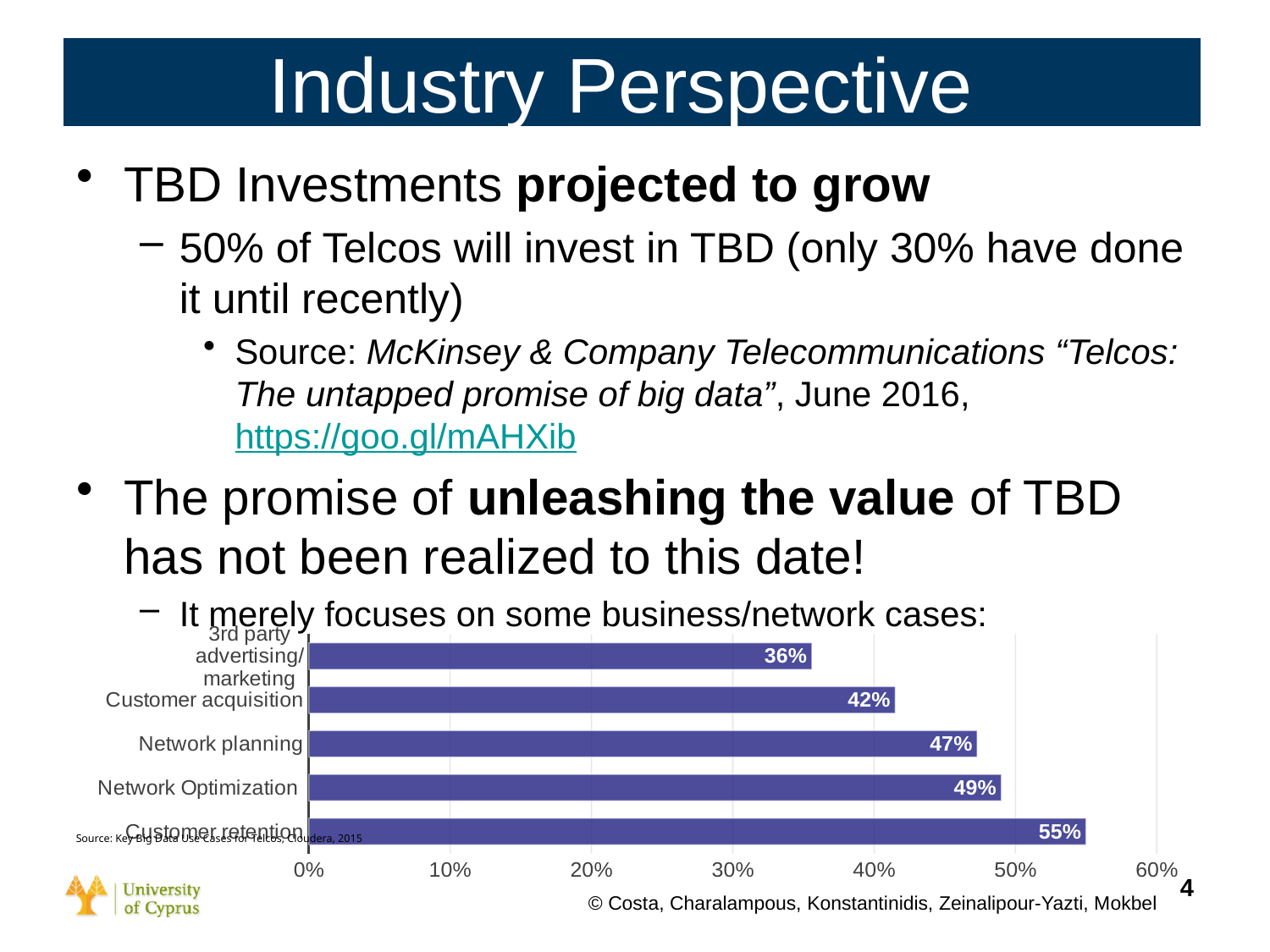
What is the value for 3rd party advertising/marketing? 36% What is the value for Network planning? 47% Is the value for Network Optimization greater or less than 40%? greater Which is larger, the value for Customer acquisition or the value for Network planning? Network planning Which category has the lowest value? 3rd party advertising/marketing What is the value for Network Optimization? 49% What is the value for Customer acquisition? 42% What is the difference between the values for Customer retention and 3rd party advertising/marketing? 19% What kind of chart is shown on the slide? Bar chart What is the value for Customer retention? 55% Which category has the highest value? Customer retention How many categories are shown in the chart? 5